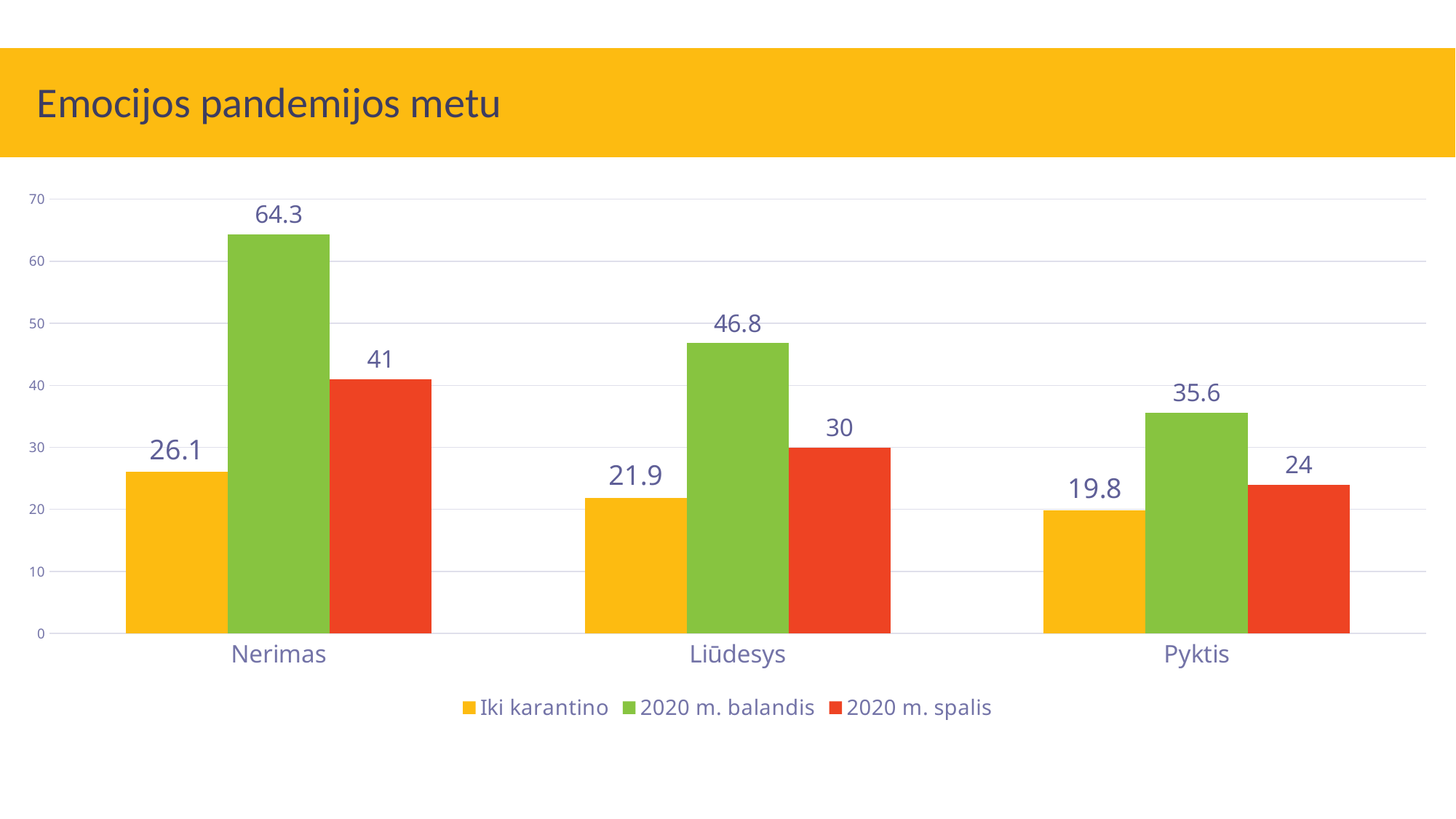
Which is larger: the 2020 m. spalis value for Nerimas or the 2020 m. balandis value for Pyktis? 2020 m. spalis value for Nerimas Which category has the lowest value in the Iki karantino series? Pyktis What is the value for Nerimas in the 2020 m. balandis series? 64.3 What kind of chart is shown on the slide? Bar chart How many categories are shown on the x axis? 3 How many series does the legend list? 3 What is the difference between the 2020 m. balandis and 2020 m. spalis values for Liūdesys? 16.8 What is the difference between the 2020 m. balandis and Iki karantino values for Nerimas? 38.2 What is the title of the slide? Emocijos pandemijos metu What is the value for Pyktis in the Iki karantino series? 19.8 What is the value for Liūdesys in the 2020 m. spalis series? 30 Which category has the highest value in the 2020 m. balandis series? Nerimas